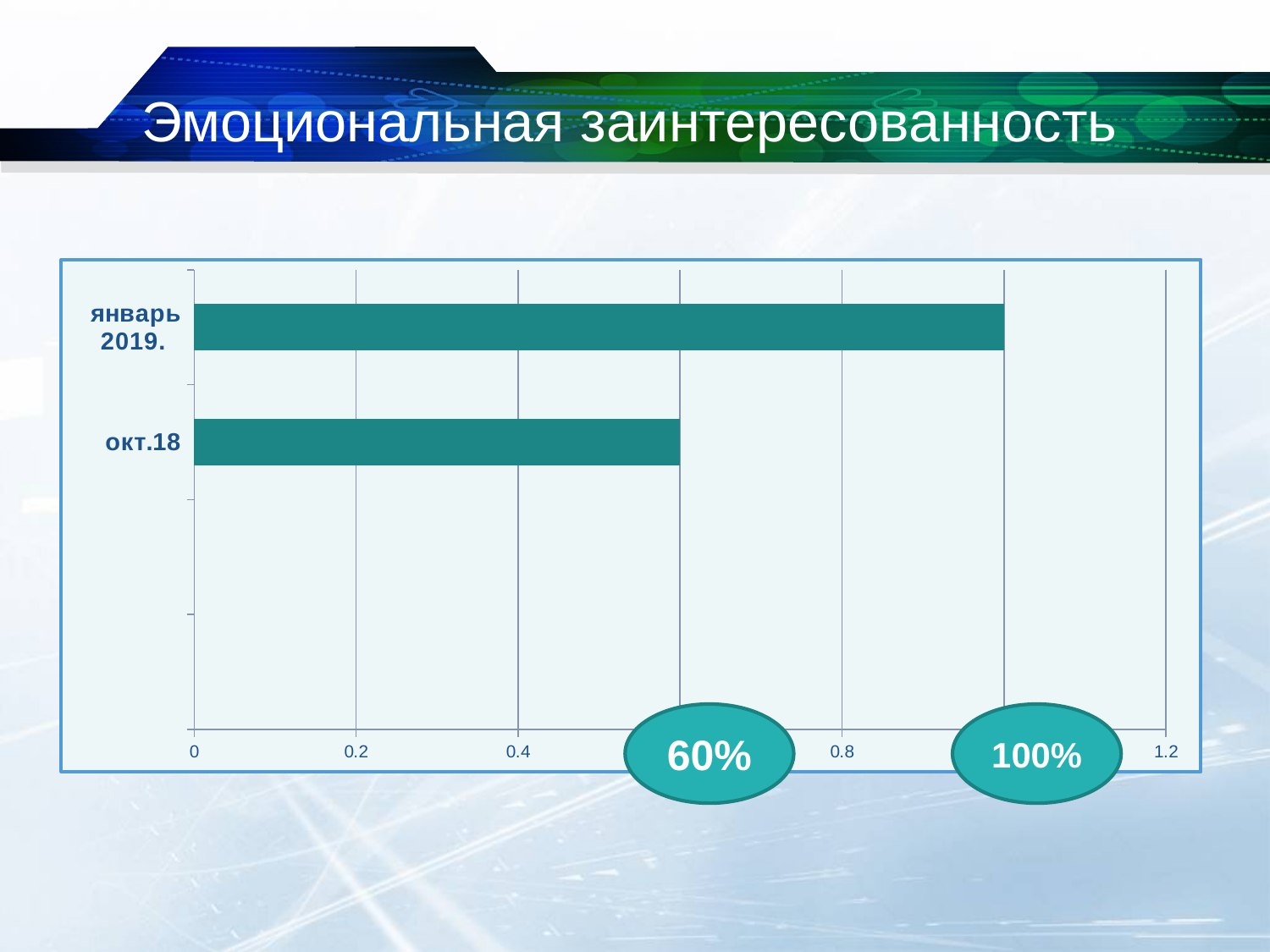
What value is shown for январь 2019? 100% Which category has the lowest value? окт.18 How many categories does the chart show? 2 What value is shown for окт.18? 60% What is the title of the slide containing the chart? Эмоциональная заинтересованность Which category has the highest value? январь 2019 Which is larger, the value for январь 2019 or the value for окт.18? январь 2019 Is the value for январь 2019 greater or less than 0.8? greater What is the highest tick value shown on the horizontal axis? 1.2 What is the difference between the values for январь 2019 and окт.18? 40% What kind of chart is shown on the slide? bar chart Is the value for окт.18 greater or less than 0.8? less